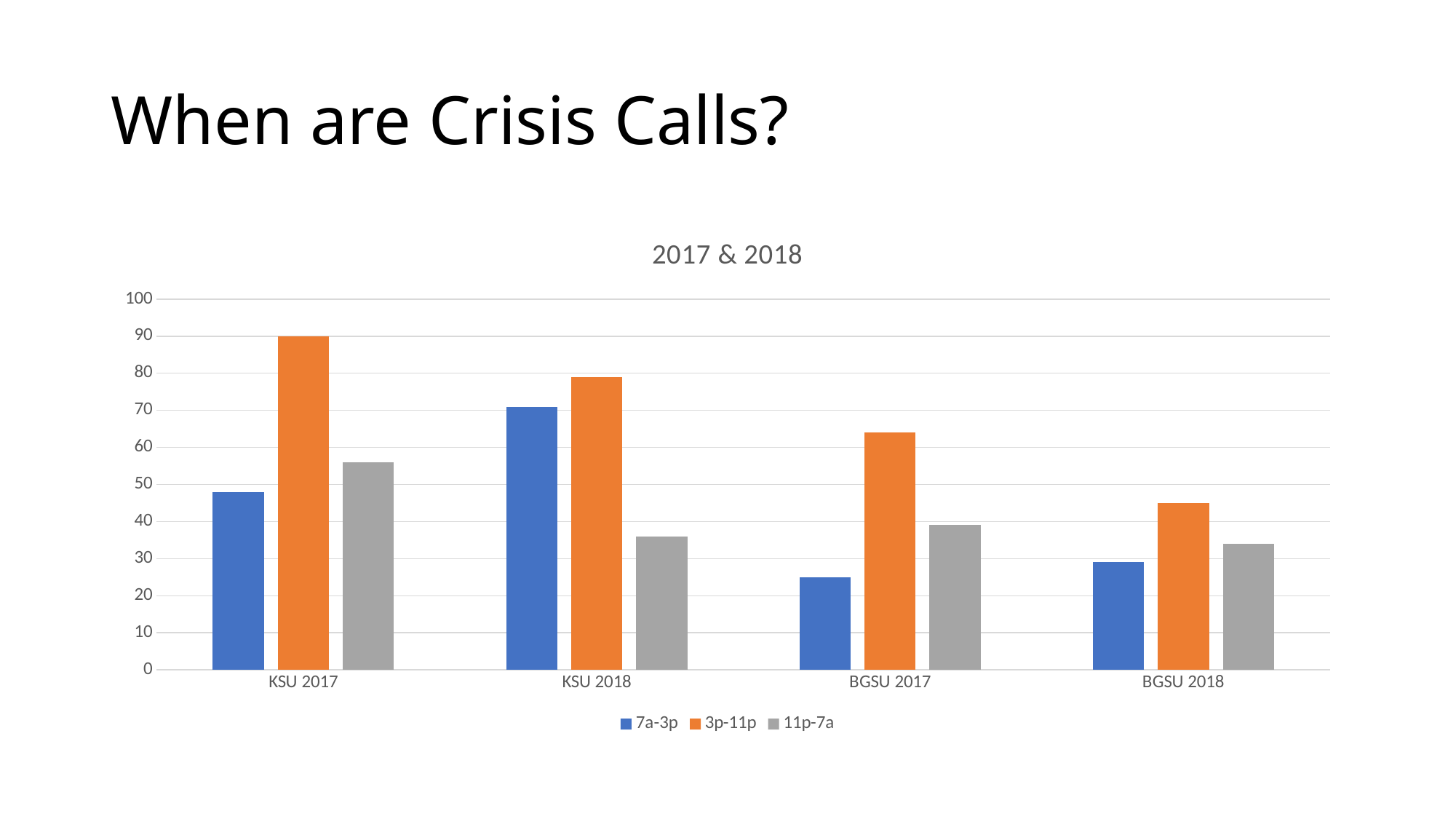
How many series does the legend list? 3 What kind of chart is shown on the slide? bar chart Which category has the highest 11p-7a value? KSU 2017 How many categories are shown on the x axis? 4 What is the title of the chart? 2017 & 2018 Which series is shown in orange? 3p-11p Which category has the lowest 7a-3p value? BGSU 2017 Which is larger at KSU 2018: the 7a-3p value or the 11p-7a value? 7a-3p Is the value for 7a-3p at KSU 2018 greater or less than 60? greater Which category has the highest 3p-11p value? KSU 2017 Is the value for 11p-7a at BGSU 2018 greater or less than 40? less What is the value for 3p-11p at KSU 2017? 90